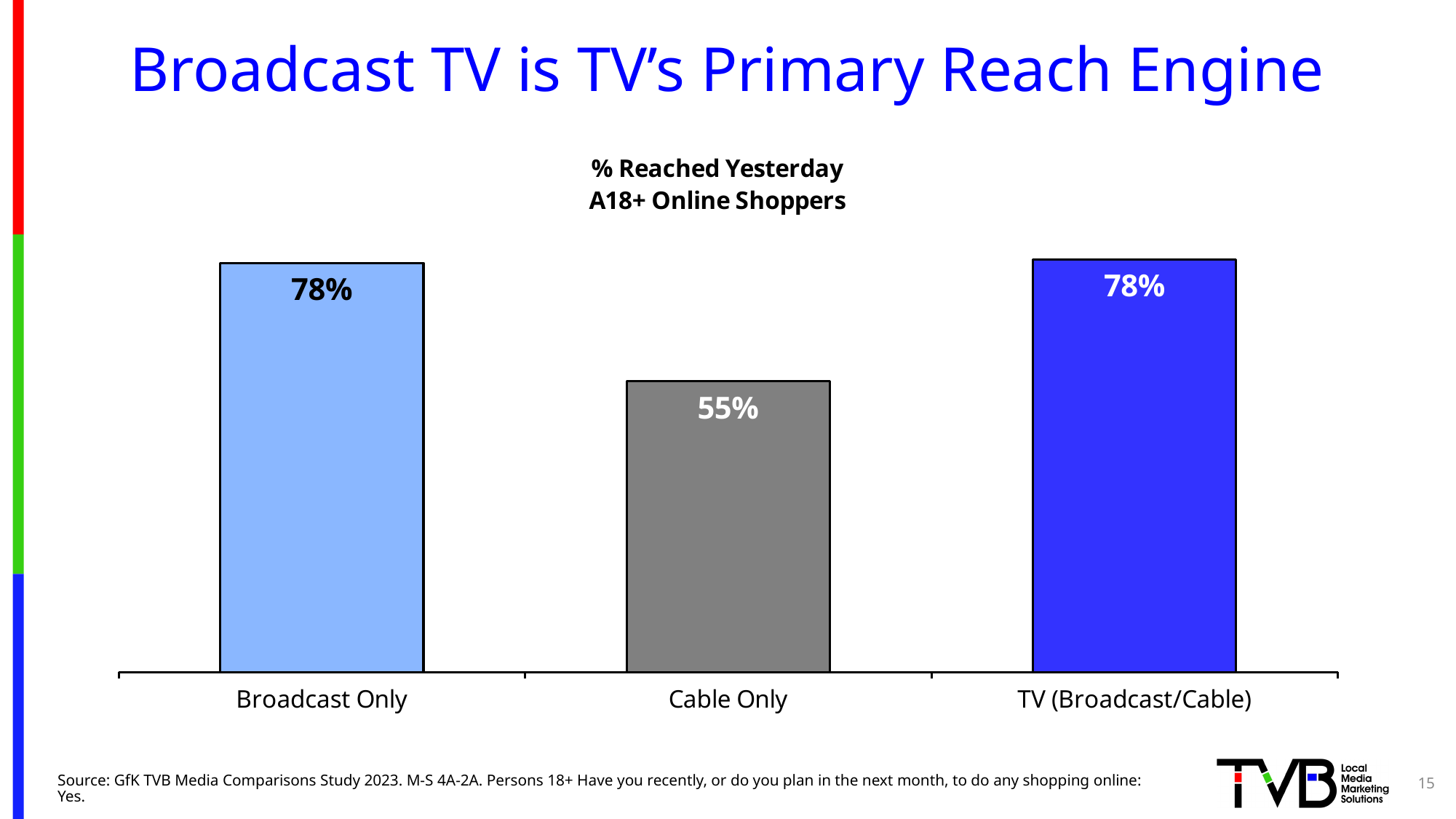
What is the difference between the Broadcast Only and Cable Only values? 23% Which is larger, the value for Cable Only or the value for TV (Broadcast/Cable)? TV (Broadcast/Cable) What colour is the Cable Only bar? Gray What is the value for Broadcast Only? 78% What is the value for Cable Only? 55% Which is larger, the value for Broadcast Only or the value for Cable Only? Broadcast Only What kind of chart is shown on the slide? Bar chart How many categories are shown in the chart? 3 Which category has the lowest value? Cable Only Do the Broadcast Only and TV (Broadcast/Cable) bars have the same value? Yes What is the value for TV (Broadcast/Cable)? 78% What is the title of the chart? % Reached Yesterday A18+ Online Shoppers